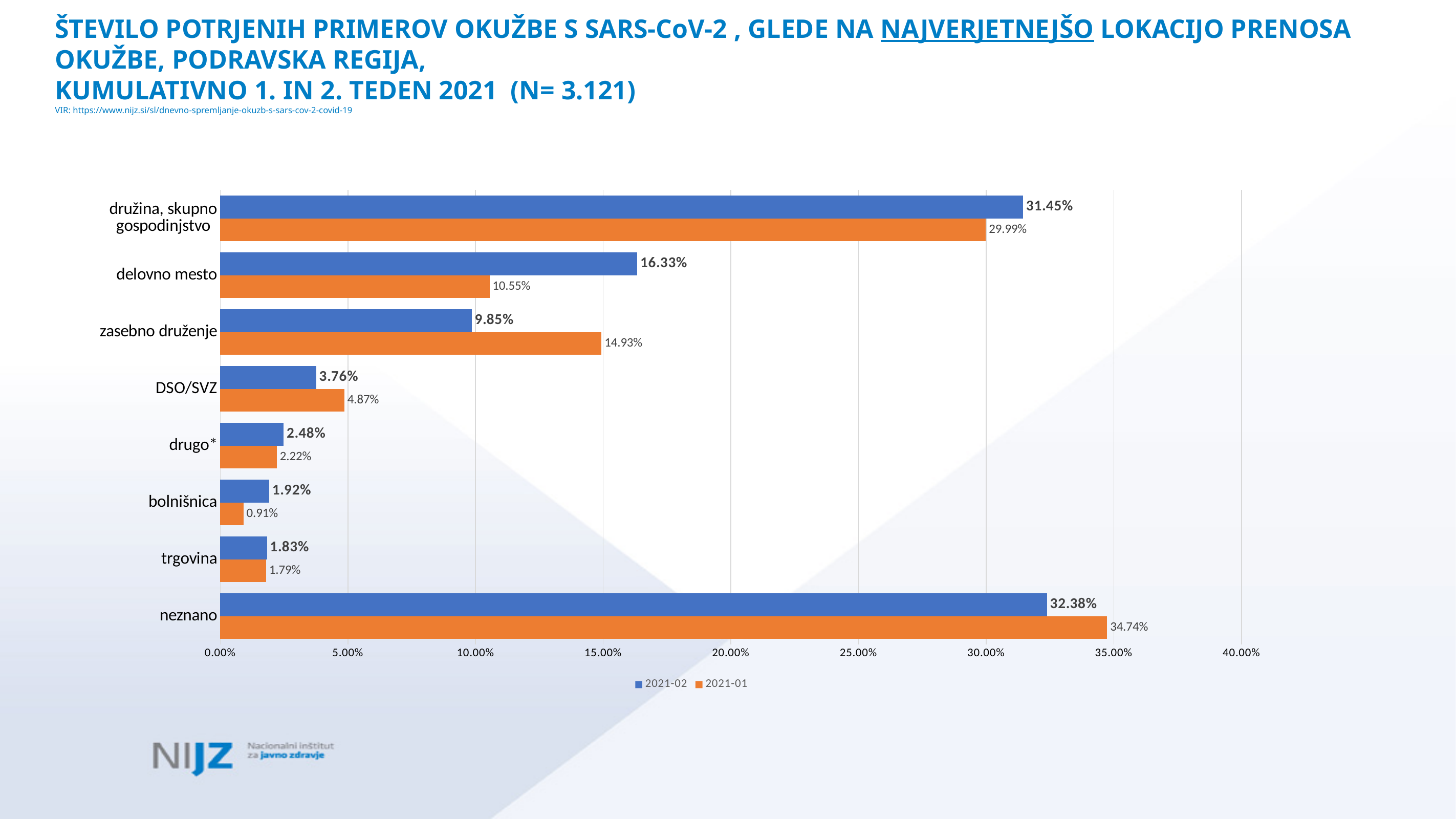
What is the value for 'delovno mesto' in the 2021-02 series? 16.33% How many categories are shown on the chart? 8 How many series does the legend list? 2 Which category has the lowest value in the 2021-02 series? trgovina What is the difference between the 2021-02 and 2021-01 values for 'delovno mesto'? 5.78% What is the value for 'bolnišnica' in the 2021-01 series? 0.91% What kind of chart is shown on the slide? bar chart Which category has the highest value in the 2021-01 series? neznano For 'zasebno druženje', which series has the larger value, 2021-02 or 2021-01? 2021-01 Is the 2021-02 value for 'družina, skupno gospodinjstvo' greater or less than 30.00%? greater Which colour represents the 2021-01 series? orange What is the value for 'zasebno druženje' in the 2021-01 series? 14.93%